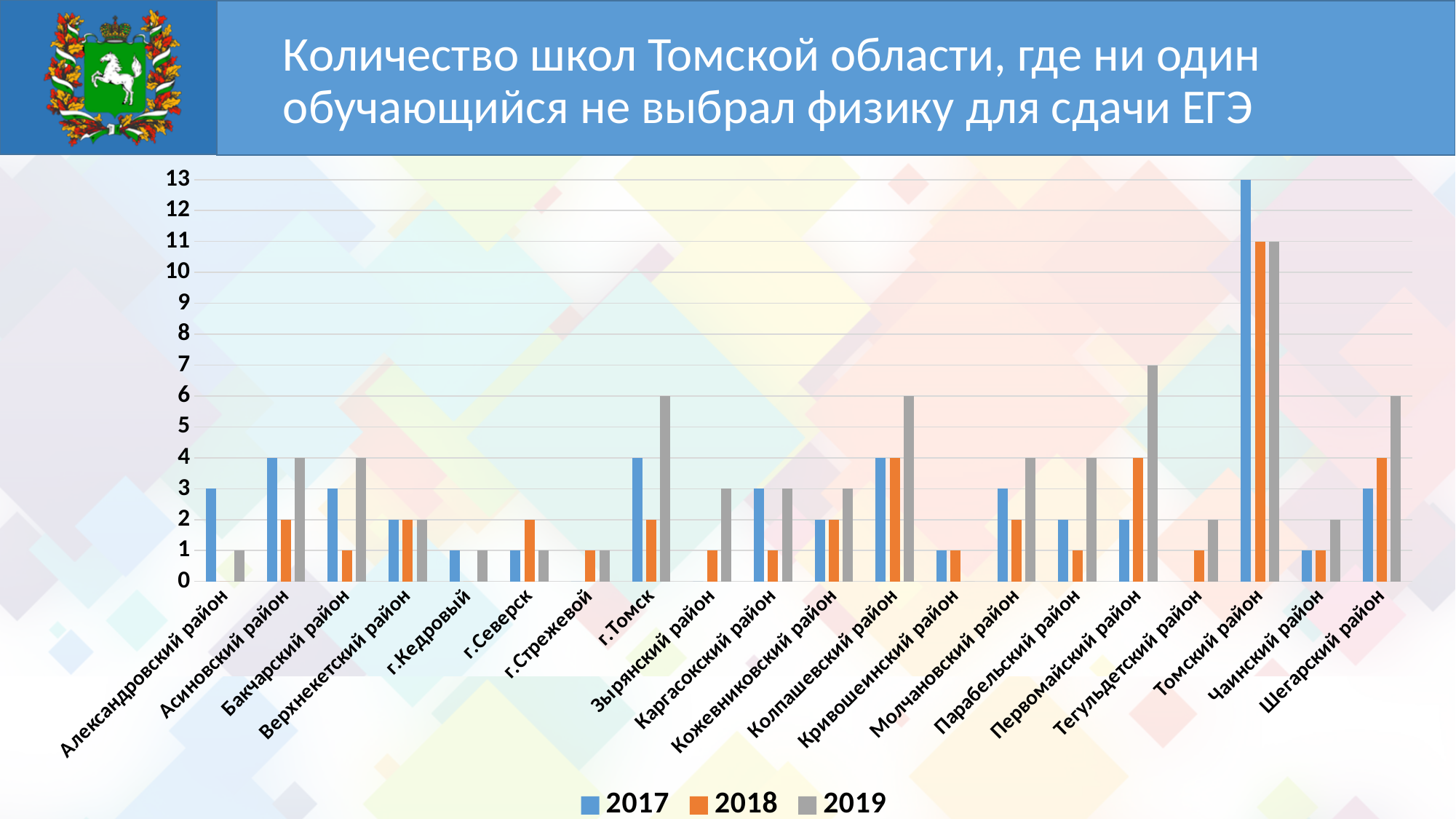
Do the values for Первомайский район rise or fall from 2017 to 2019? rise What is the value for Томский район in 2017? 13 Which colour represents the 2018 series in the legend? orange What is the value for г.Томск in 2019? 6 Is the value for Томский район in 2019 greater or less than 10? greater What is the difference between the 2017 and 2018 values for Томский район? 2 How many districts (categories) are shown on the x axis? 20 Which is larger for Шегарский район: the 2018 value or the 2019 value? 2019 What is the value for Первомайский район in 2019? 7 Which district has the highest value for 2017? Томский район How many series does the legend list? 3 What kind of chart is shown on the slide? bar chart